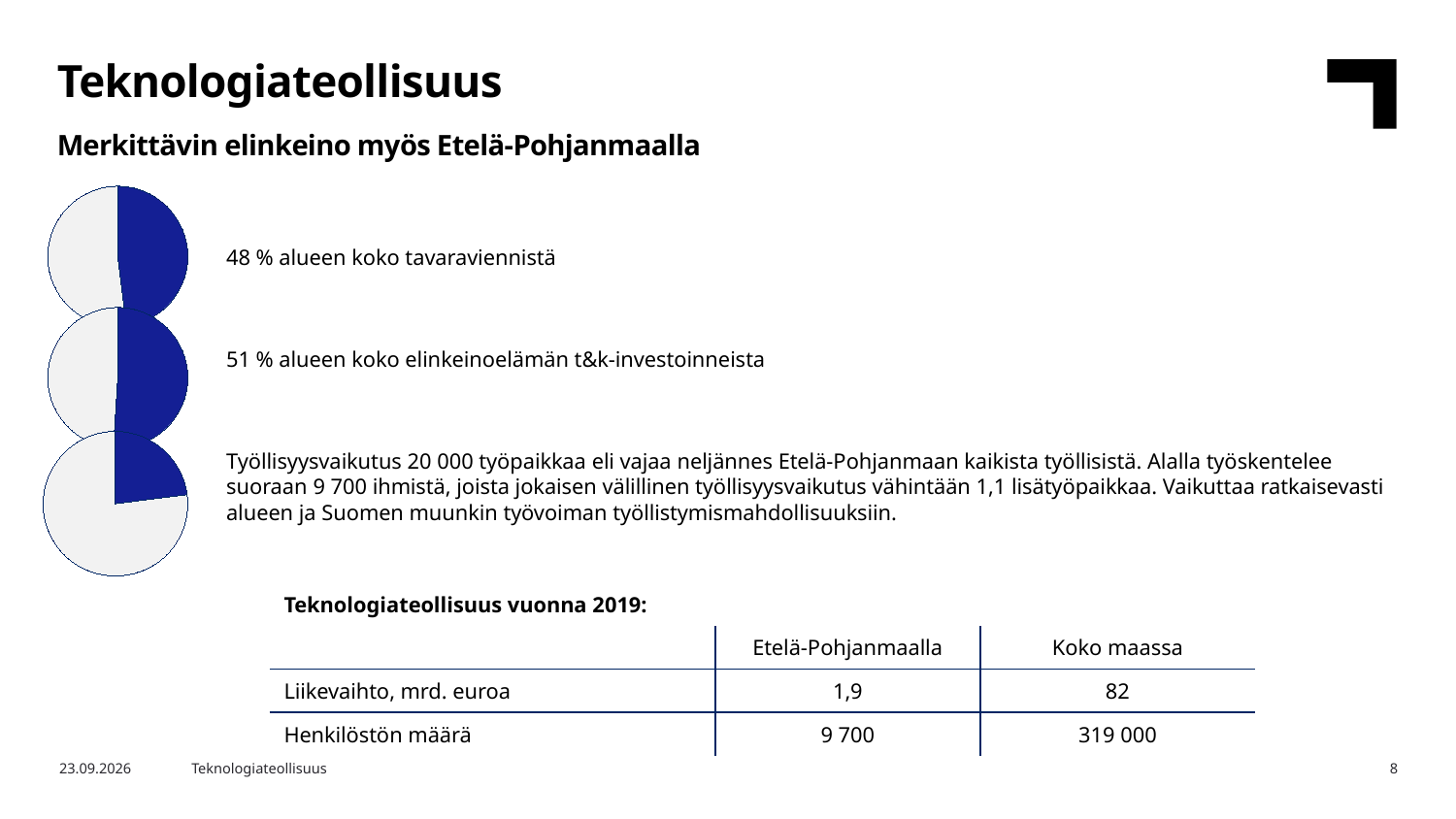
What is the title of the slide containing the pie charts? Teknologiateollisuus What colour is the highlighted slice in the pie charts? Blue Which pie chart has the smallest highlighted slice: the top, middle or bottom one? Bottom What kind of chart is shown on the left side of the slide? Pie chart In the middle pie chart, what share of the region's business R&D investments (t&k-investoinnit) does the highlighted slice represent? 51 % Which pie chart has the largest highlighted slice: the top, middle or bottom one? Middle In the top pie chart, what share of the region's total goods exports (tavaravienti) does the highlighted slice represent? 48 % How many pie charts are on the slide? 3 Is the highlighted slice in the bottom pie chart more or less than half of the pie? Less Is the highlighted slice in the bottom pie chart larger or smaller than the highlighted slice in the top pie chart? Smaller How many slices does the top pie chart have? 2